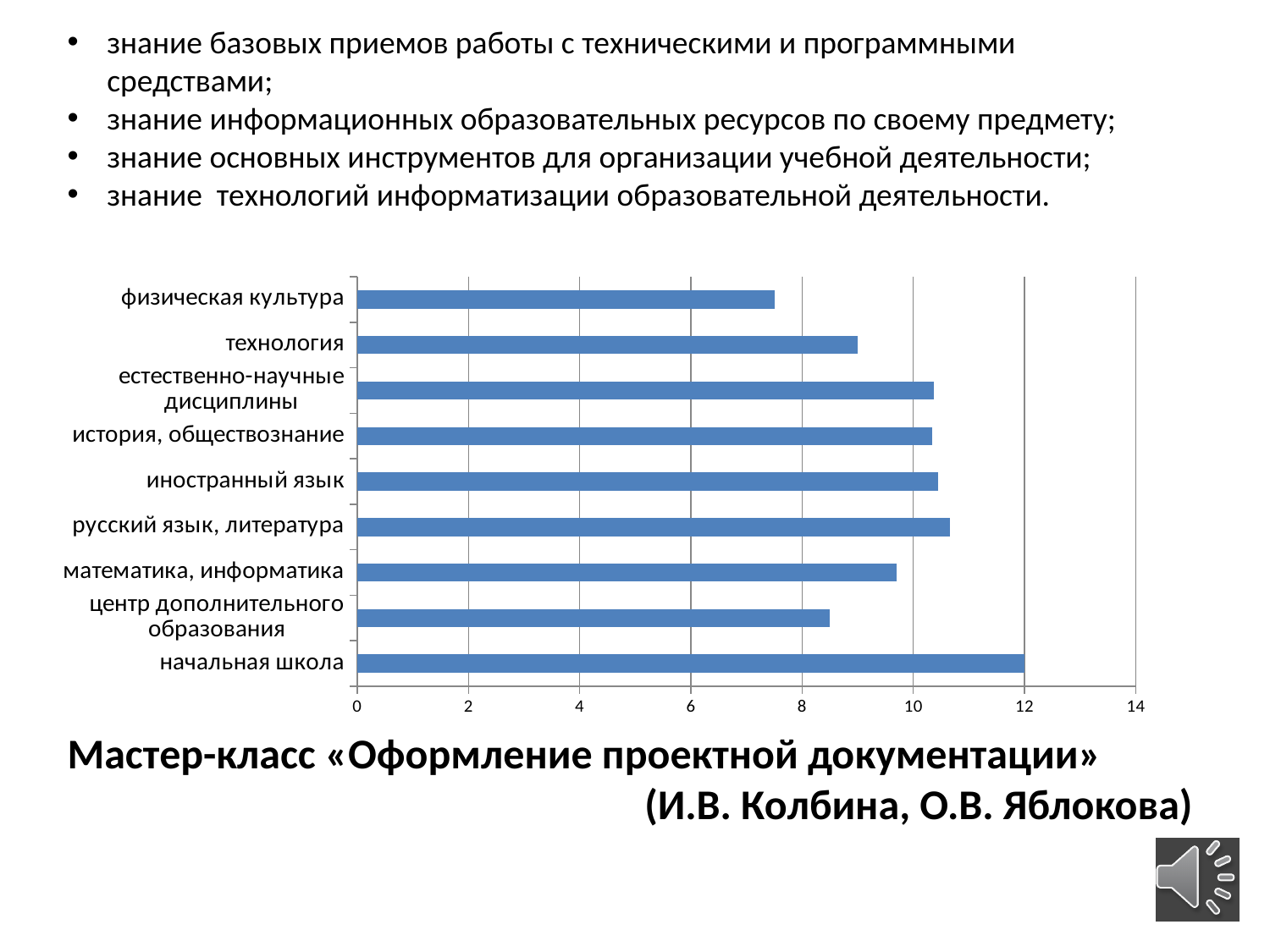
Which is larger: the value for технология or the value for центр дополнительного образования? технология Is the value for русский язык, литература greater or less than 10? greater Which category has the lowest value in the bar chart? физическая культура Which is larger: the value for математика, информатика or the value for технология? математика, информатика Is the value for начальная школа greater or less than 10? greater Which category has the highest value in the bar chart? начальная школа Is the value for математика, информатика greater or less than 10? less How many categories are plotted in the bar chart? 9 What is the maximum value shown on the horizontal axis of the chart? 14 What kind of chart is shown on the slide? bar chart